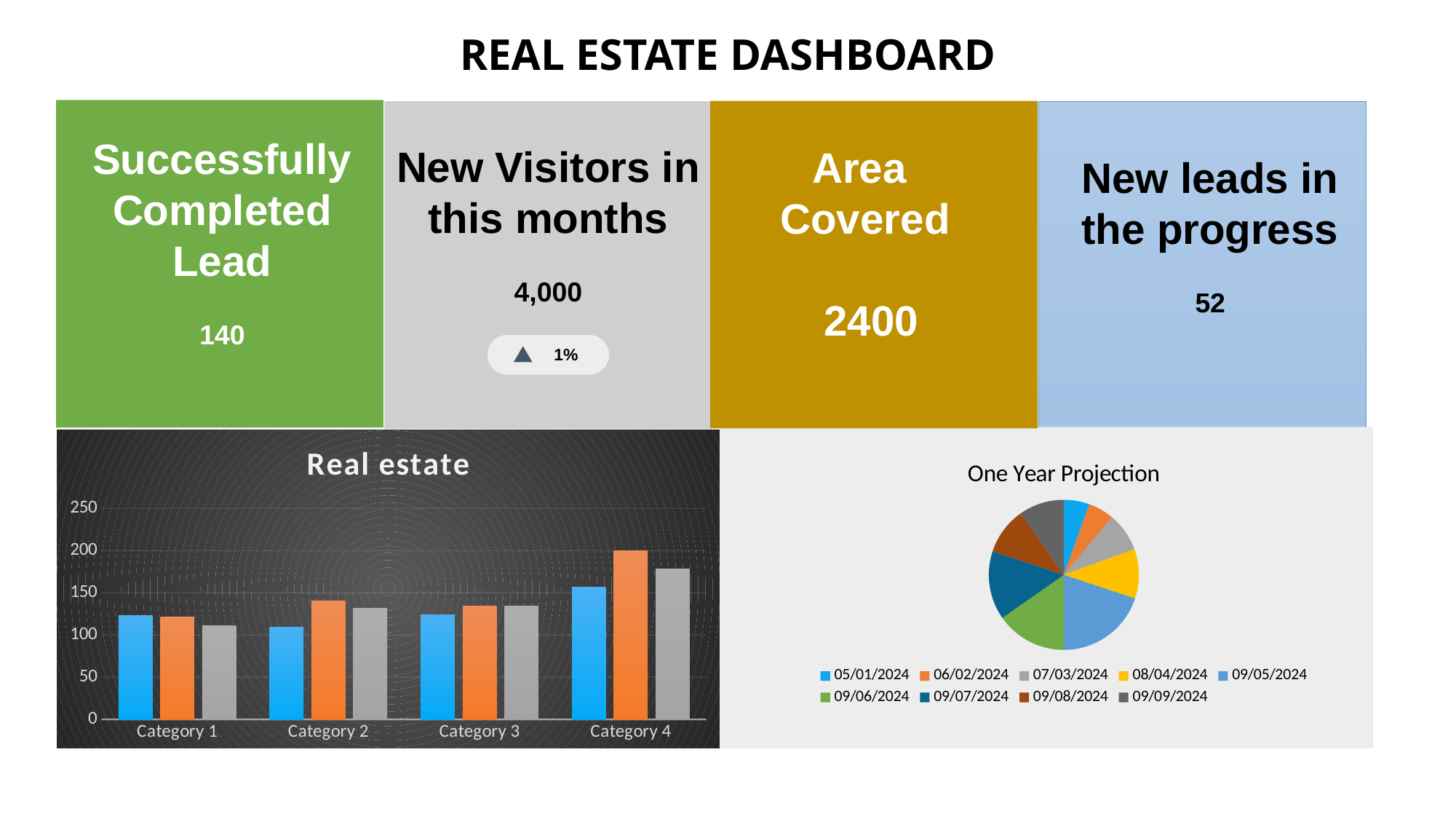
What is the title of the pie chart on the slide? One Year Projection What kind of chart is the "One Year Projection" chart? pie chart How many entries does the legend of the "One Year Projection" chart list? 9 In the "Real estate" chart, which category has the tallest gray bar? Category 4 In the "Real estate" chart, which is larger for Category 4: the orange bar or the gray bar? the orange bar In the "One Year Projection" chart, which date has the largest slice? 09/05/2024 In the "Real estate" chart, is the orange bar for Category 2 greater or less than 150? less How many categories are shown on the x axis of the "Real estate" chart? 4 What kind of chart is the "Real estate" chart? bar chart In the "Real estate" chart, is the gray bar for Category 1 greater or less than 100? greater In the "Real estate" chart, is the gray bar for Category 4 greater or less than 150? greater In the "Real estate" chart, which category has the tallest orange bar? Category 4